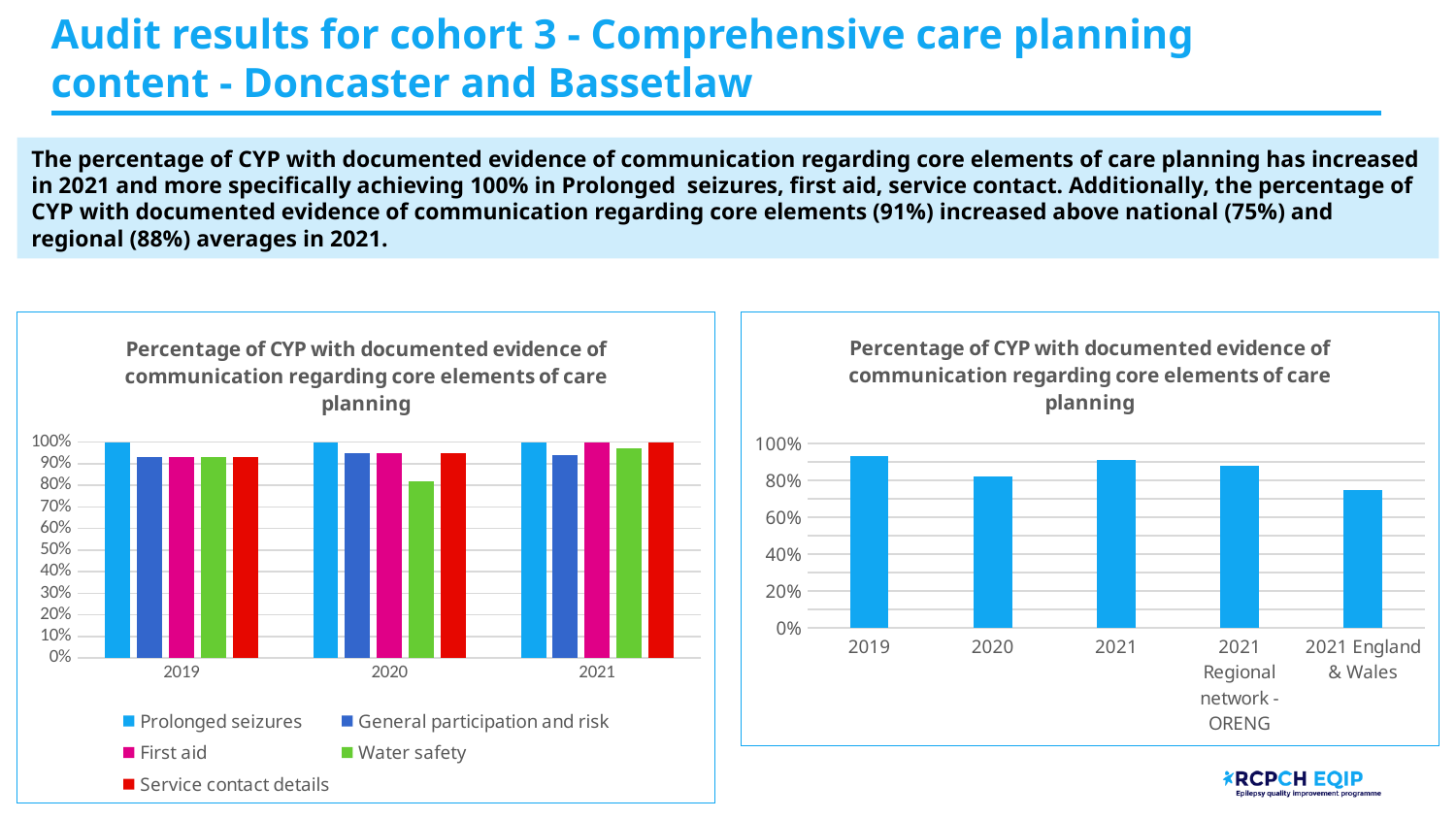
How many bars are shown in the right chart? 5 What kind of chart is the left chart on the slide? bar chart In the left chart, which is larger in 2021: Water safety or General participation and risk? Water safety In the right chart, which category has the lowest value? 2021 England & Wales In the left chart, what is the value for Prolonged seizures in 2019? 100% In the right chart, is the value for 2020 greater or less than 90%? less In the left chart, is the value for Water safety in 2020 greater or less than 90%? less How many series does the legend of the left chart list? 5 How many year categories are shown on the x axis of the left chart? 3 In the left chart, which series has the lowest value in 2020? Water safety What kind of chart is the right chart on the slide? bar chart In the left chart, what colour represents Service contact details in the legend? red